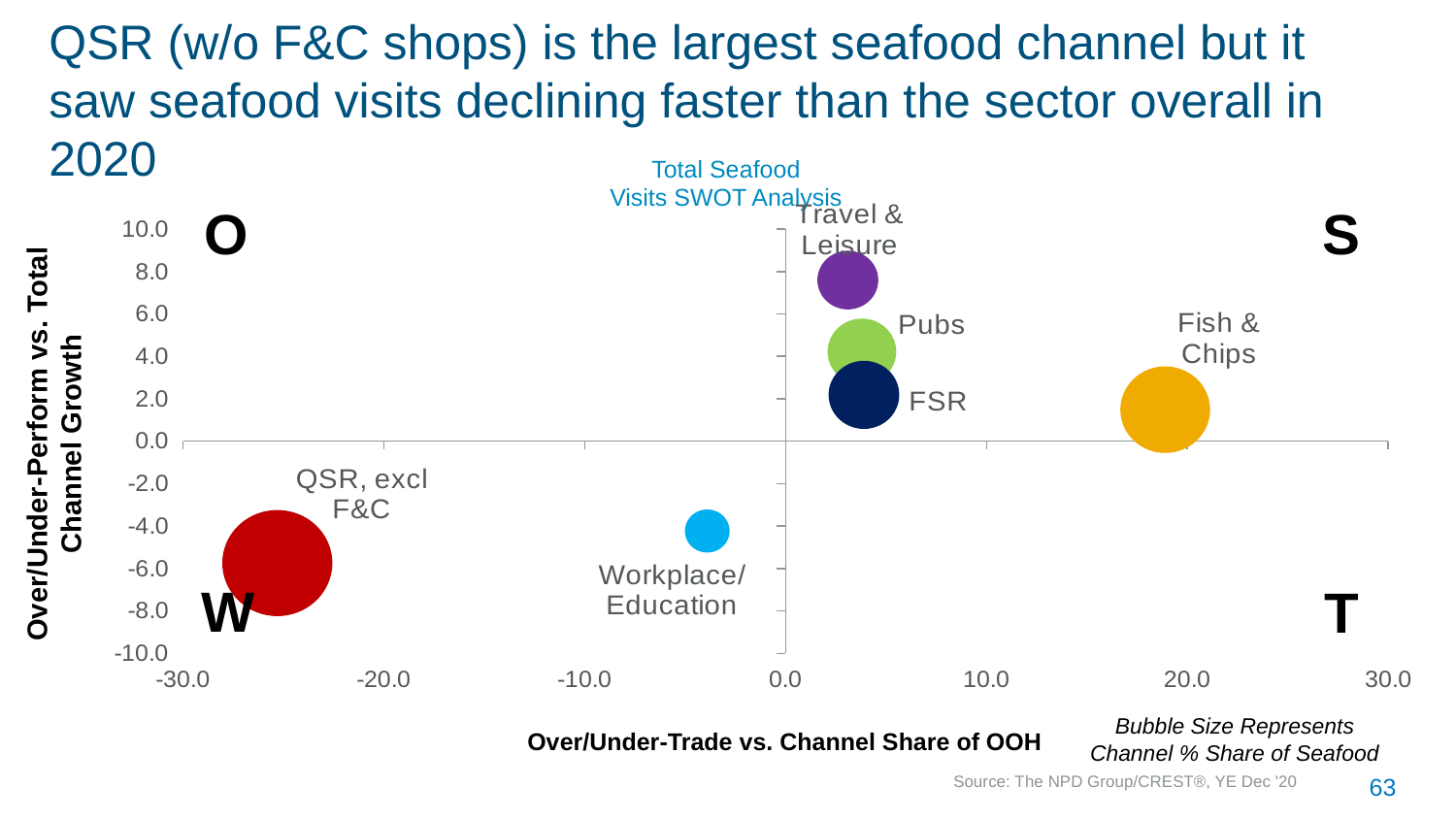
Is the Over/Under-Trade vs. Channel Share of OOH value for Fish & Chips greater or less than 10.0? greater Which has the higher Over/Under-Perform vs. Total Channel Growth value, Travel & Leisure or FSR? Travel & Leisure How many channel bubbles are plotted on the chart? 6 Which channel has the highest Over/Under-Perform vs. Total Channel Growth value? Travel & Leisure Is the Over/Under-Trade vs. Channel Share of OOH value for QSR, excl F&C greater or less than -20.0? less What is the title of the chart? Total Seafood Visits SWOT Analysis Which channel has the lowest Over/Under-Perform vs. Total Channel Growth value? QSR, excl F&C Which channel has the highest Over/Under-Trade vs. Channel Share of OOH value? Fish & Chips Which channel has the lowest Over/Under-Trade vs. Channel Share of OOH value? QSR, excl F&C Is the Over/Under-Perform vs. Total Channel Growth value for Travel & Leisure greater or less than 6.0? greater What kind of chart is shown on the slide? Bubble chart